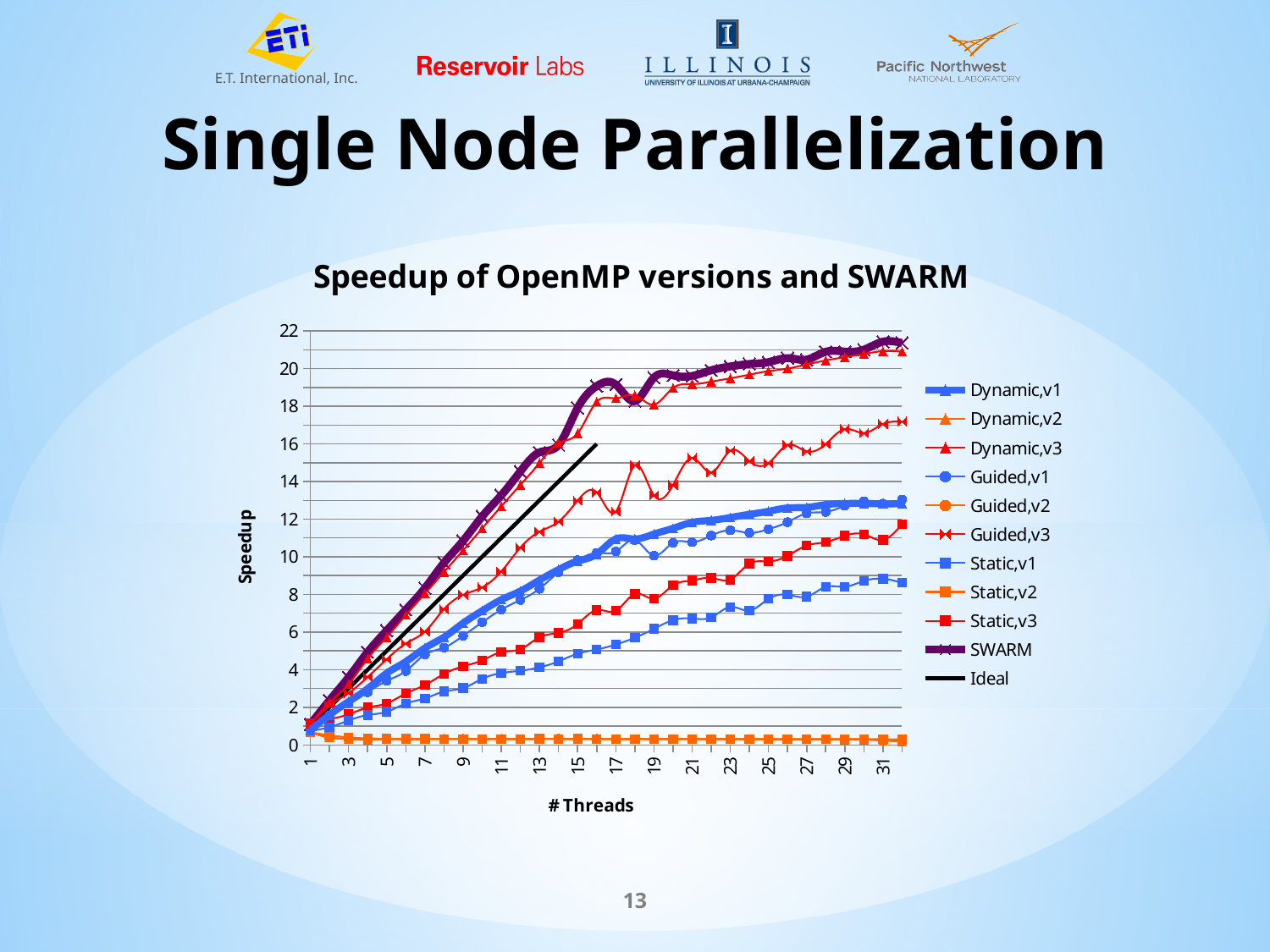
Is the Static,v1 speedup at 32 threads greater or less than 10? less Is the Static,v3 speedup at 32 threads greater or less than 14? less Is the SWARM speedup at 32 threads greater or less than 20? greater At 32 threads, which has the larger speedup, SWARM or Static,v1? SWARM Does the SWARM speedup rise or fall as the number of threads increases? rise What is the label of the x axis? # Threads How many series does the legend list? 11 What kind of chart is shown on the slide? line chart At 32 threads, which has the larger speedup, Dynamic,v3 or Guided,v3? Dynamic,v3 What is the title of the chart? Speedup of OpenMP versions and SWARM